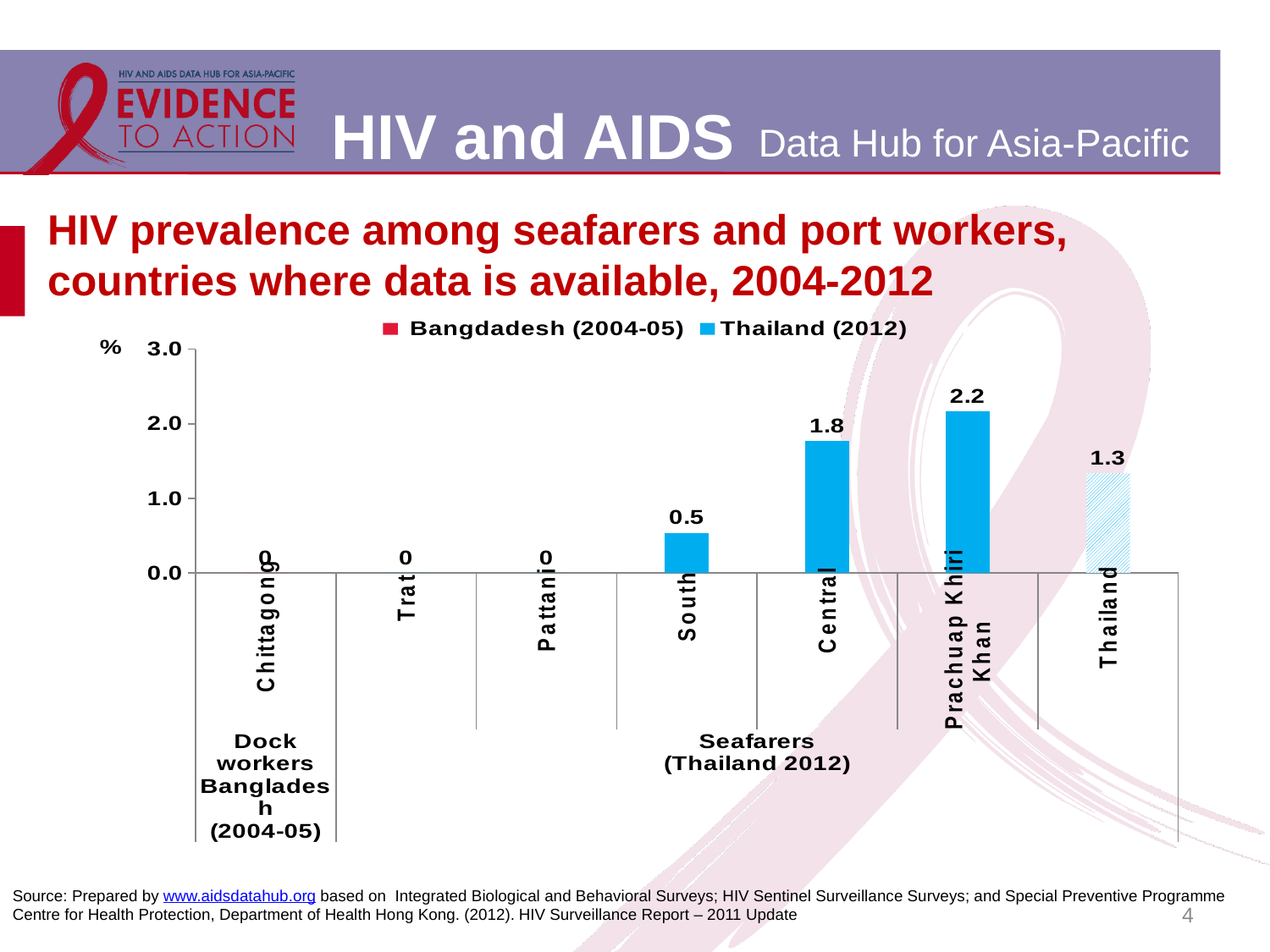
What is the difference between the values for Prachuap Khiri Khan and Central? 0.4 How many series does the legend list? 2 What is the HIV prevalence value shown for Chittagong? 0 How many categories are shown along the x axis of the chart? 7 What is the HIV prevalence value shown for Central? 1.8 What is the HIV prevalence value shown for South? 0.5 What is the HIV prevalence value shown for Prachuap Khiri Khan? 2.2 What is the HIV prevalence value shown for Thailand? 1.3 What kind of chart is shown on the slide? Bar chart Is the value for Prachuap Khiri Khan greater or less than 2.0? greater Which category has the highest HIV prevalence in the chart? Prachuap Khiri Khan Which is larger, the value for Central or the value for Thailand? Central